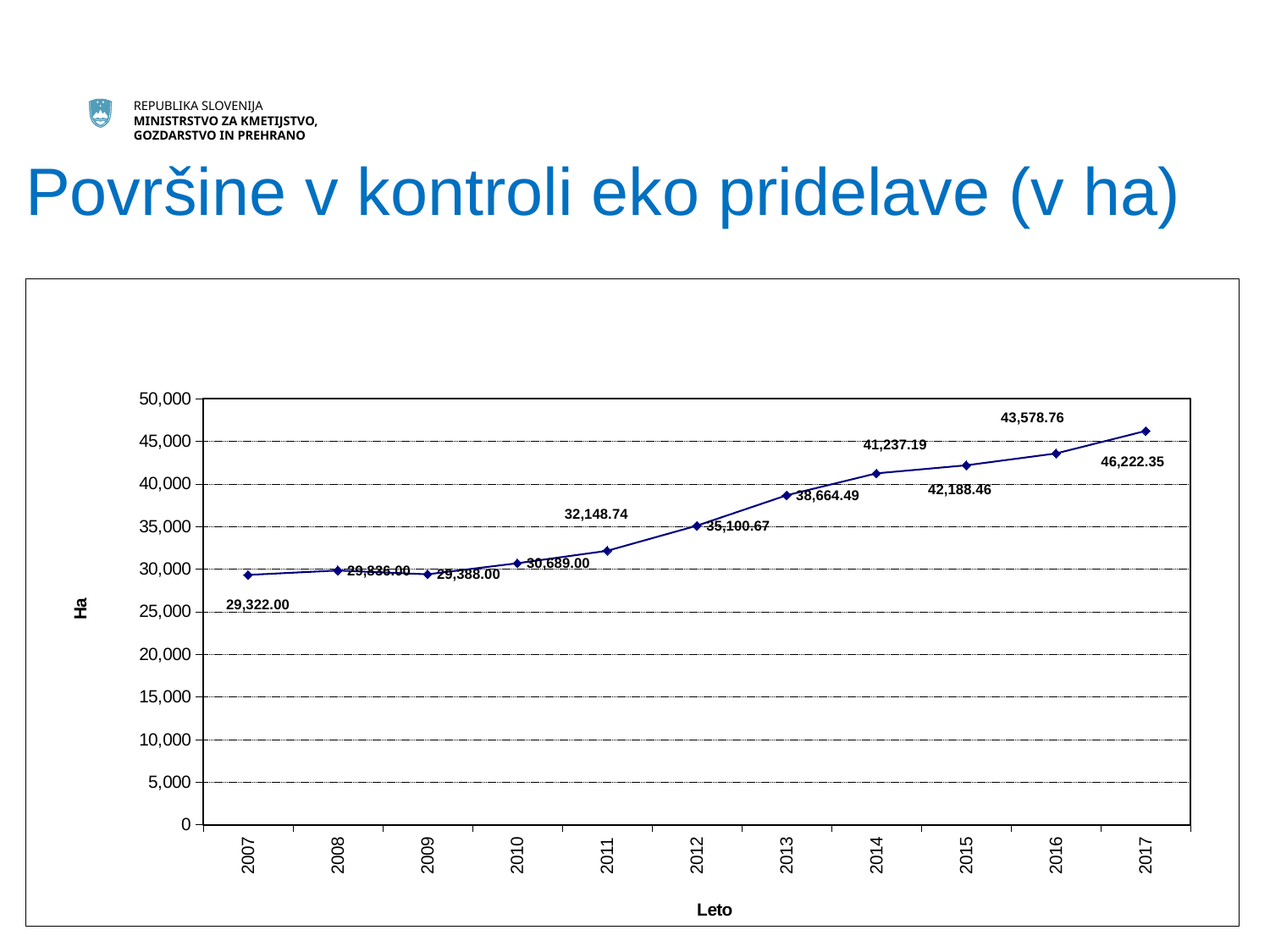
Which year has the highest value? 2017 What is the value for 2013? 38,664.49 What type of chart is shown on the slide? Line chart What is the value for 2017? 46,222.35 How many years are plotted on the x axis? 11 What is the value for 2011? 32,148.74 Is the value for 2014 greater or less than 40,000? greater What is the difference between the values for 2017 and 2007? 16,900.35 Do the values generally rise or fall from 2007 to 2017? Rise Which is larger, the value for 2015 or the value for 2012? 2015 What is the difference between the values for 2013 and 2012? 3,563.82 What is the value for 2007? 29,322.00